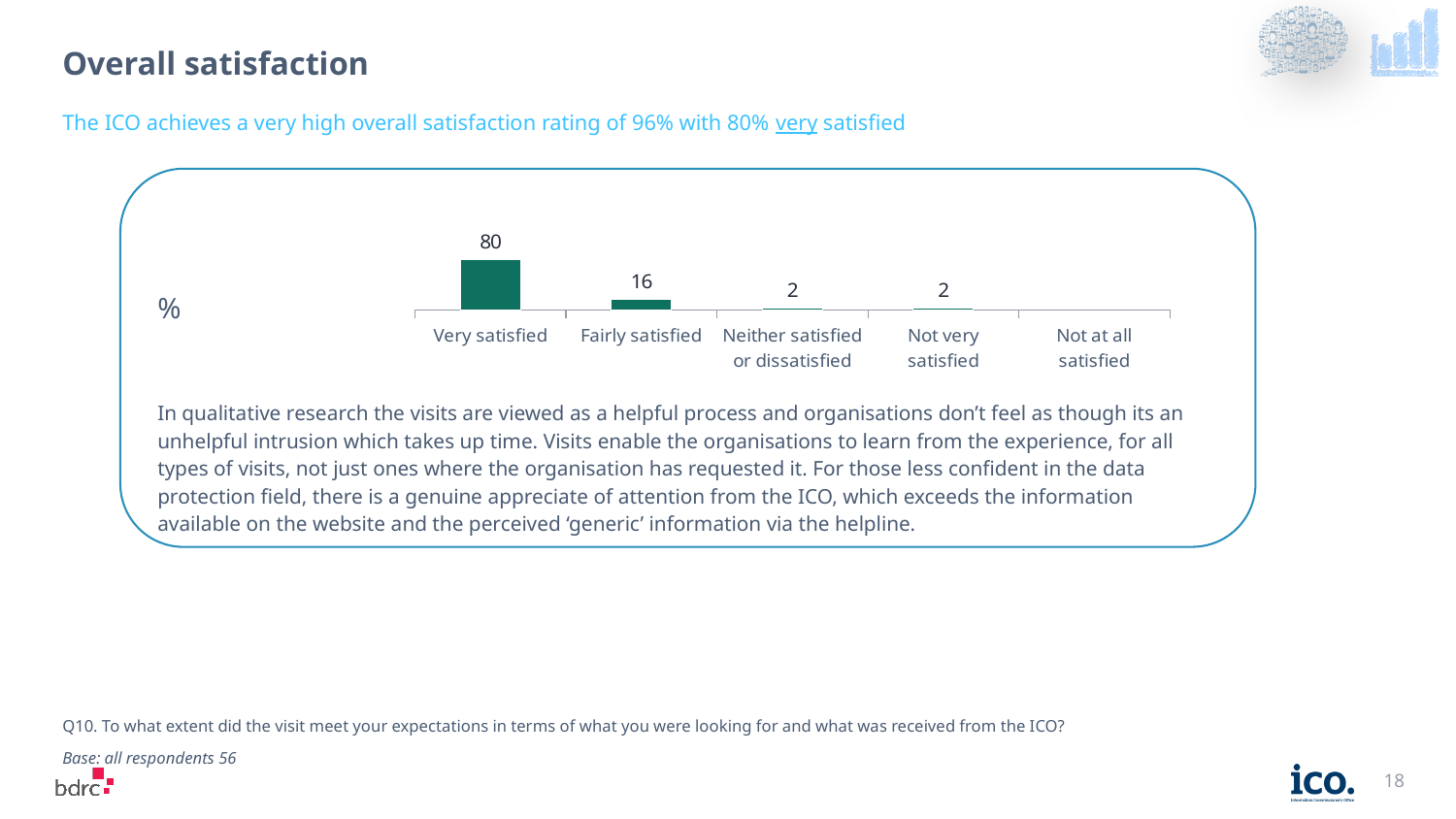
What is the value for Very satisfied? 80 What is the value for Not very satisfied? 2 Which is larger, the value for Fairly satisfied or the value for Not very satisfied? Fairly satisfied What is the difference between the values for Very satisfied and Fairly satisfied? 64 What is the value for Fairly satisfied? 16 What is the value for Neither satisfied or dissatisfied? 2 How many categories are shown on the x axis? 5 What kind of chart is shown on the slide? Bar chart Which category has the highest value? Very satisfied What unit label is shown to the left of the chart? % What is the combined value of Very satisfied and Fairly satisfied? 96 Do the values rise or fall from Very satisfied to Not very satisfied along the x axis? Fall